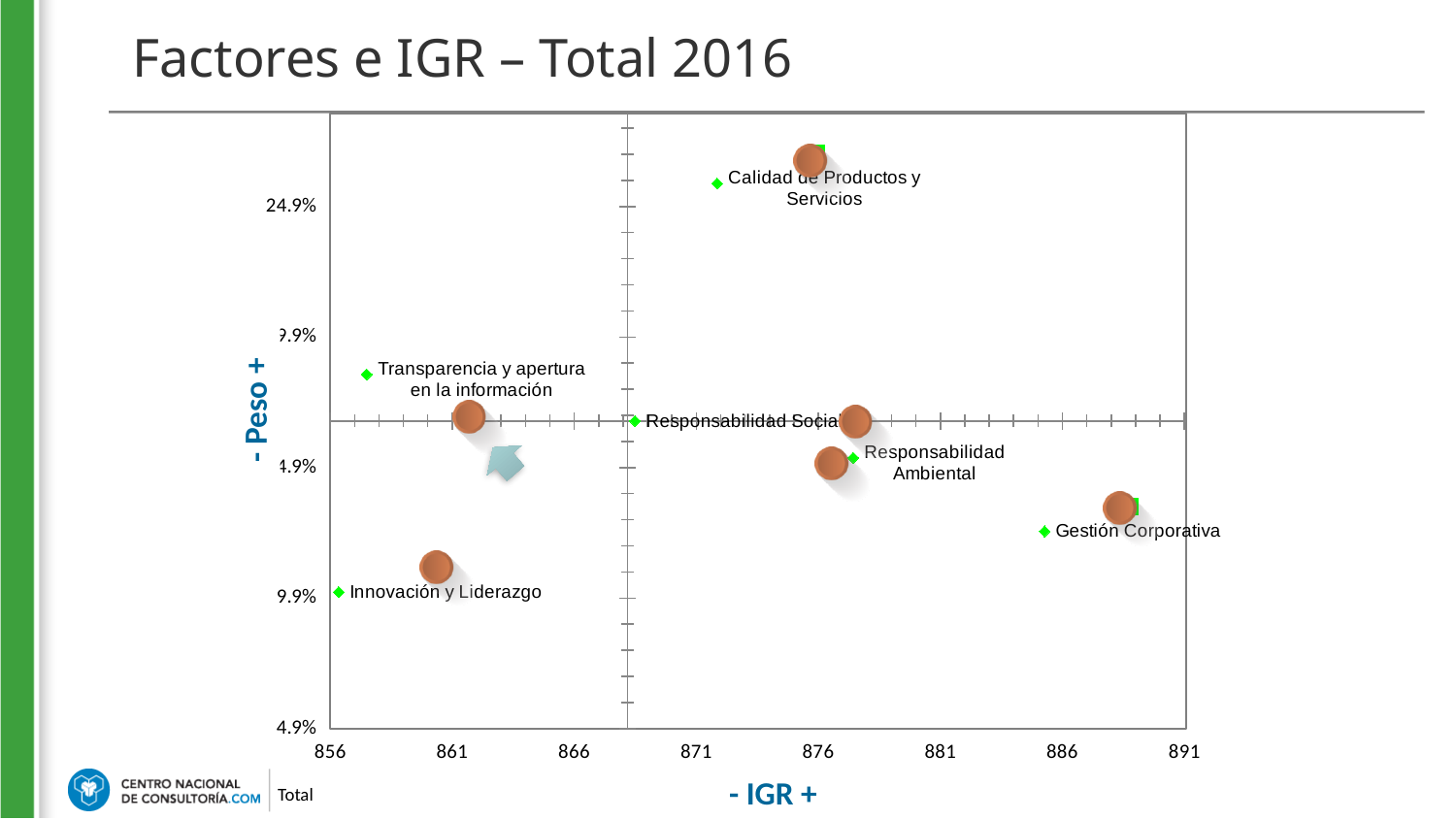
What kind of chart is shown on the slide? Scatter chart Which has a higher Peso value, Transparencia y apertura en la información or Gestión Corporativa? Transparencia y apertura en la información Which factor has the highest IGR value? Gestión Corporativa Is the Peso value for Calidad de Productos y Servicios greater or less than 24.9%? greater Which factor has the highest Peso value? Calidad de Productos y Servicios What is the title of the chart on the slide? Factores e IGR – Total 2016 Is the IGR value for Gestión Corporativa greater or less than 881? greater Which factor has the lowest Peso value? Innovación y Liderazgo Which has a higher IGR value, Gestión Corporativa or Innovación y Liderazgo? Gestión Corporativa How many labeled factors are plotted on the chart? 6